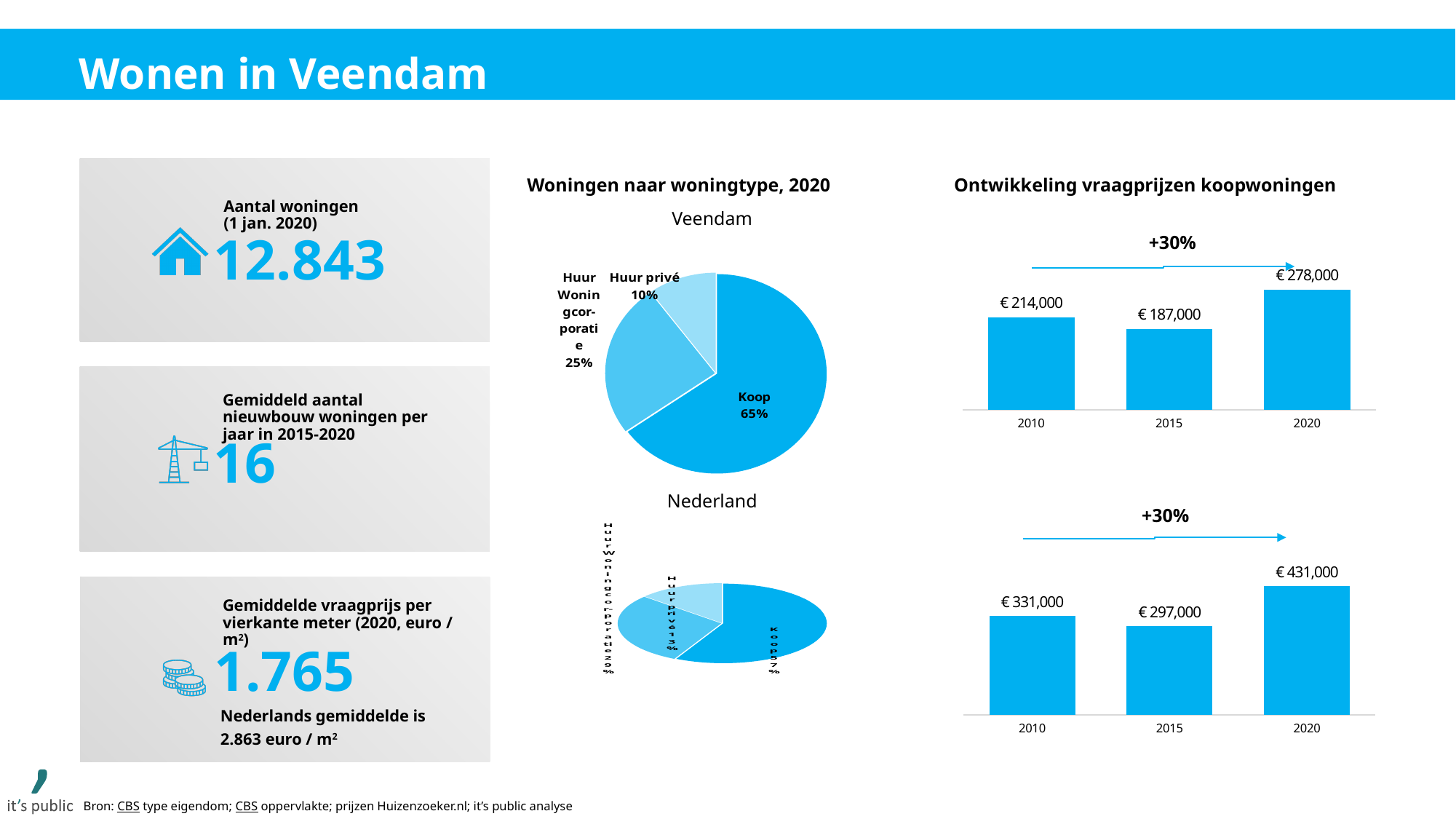
In the Veendam pie chart, how many slices are there? 3 What kind of chart is used for 'Woningen naar woningtype, 2020' for Veendam? Pie chart In the upper bar chart under 'Ontwikkeling vraagprijzen koopwoningen', what is the value for 2020? € 278,000 In the Veendam pie chart, which category has the smallest share? Huur privé In the upper bar chart under 'Ontwikkeling vraagprijzen koopwoningen', which year has the lowest value? 2015 In the Veendam pie chart, what share of homes is Huur privé? 10% In the lower bar chart under 'Ontwikkeling vraagprijzen koopwoningen', which year has the highest value? 2020 In the Veendam pie chart, which category has the largest share? Koop In the Veendam pie chart, what share of homes is Koop? 65% In the lower bar chart under 'Ontwikkeling vraagprijzen koopwoningen', what is the value for 2015? € 297,000 In the lower bar chart under 'Ontwikkeling vraagprijzen koopwoningen', is the value for 2010 larger or smaller than the value for 2015? Larger In the upper bar chart under 'Ontwikkeling vraagprijzen koopwoningen', what is the difference between the 2020 and 2010 values? € 64,000